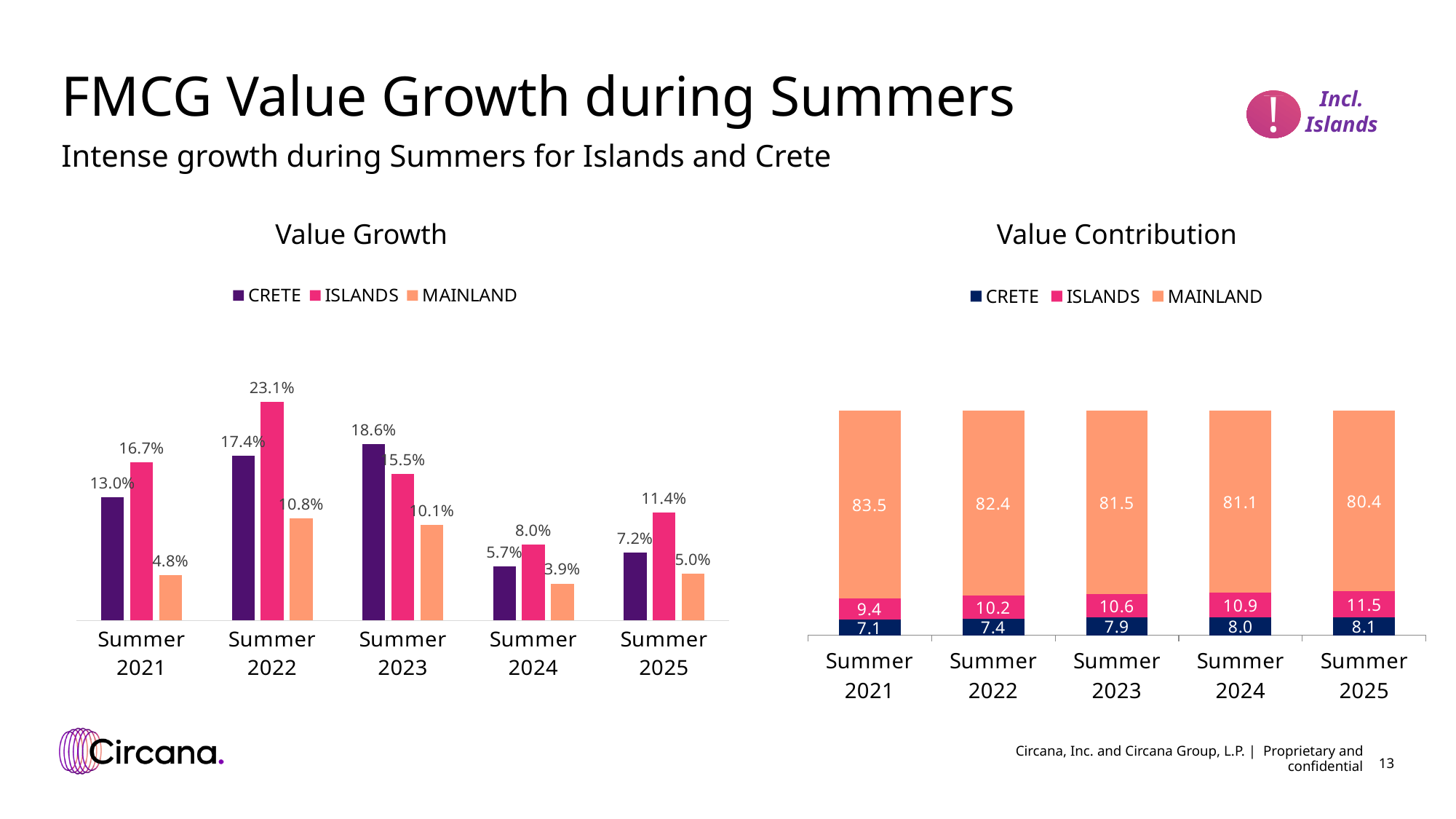
In the Value Contribution chart, what is the CRETE value for Summer 2025? 8.1 In the Value Growth chart, what is the value for ISLANDS in Summer 2022? 23.1% In the Value Contribution chart, what is the MAINLAND value for Summer 2023? 81.5 In the Value Growth chart, what is the difference between the ISLANDS and CRETE values in Summer 2025? 4.2% In the Value Growth chart, what is the value for MAINLAND in Summer 2024? 3.9% How many series does the legend of the Value Growth chart list? 3 In the Value Growth chart, which summer has the highest CRETE value? Summer 2023 In the Value Growth chart, which is larger in Summer 2021: CRETE or ISLANDS? ISLANDS In the Value Contribution chart, what is the total of the stacked bar for Summer 2021? 100 In the Value Growth chart, which summer has the lowest MAINLAND value? Summer 2024 In the Value Contribution chart, does the MAINLAND value rise or fall from Summer 2021 to Summer 2025? fall What kind of chart is the Value Contribution chart? stacked bar chart